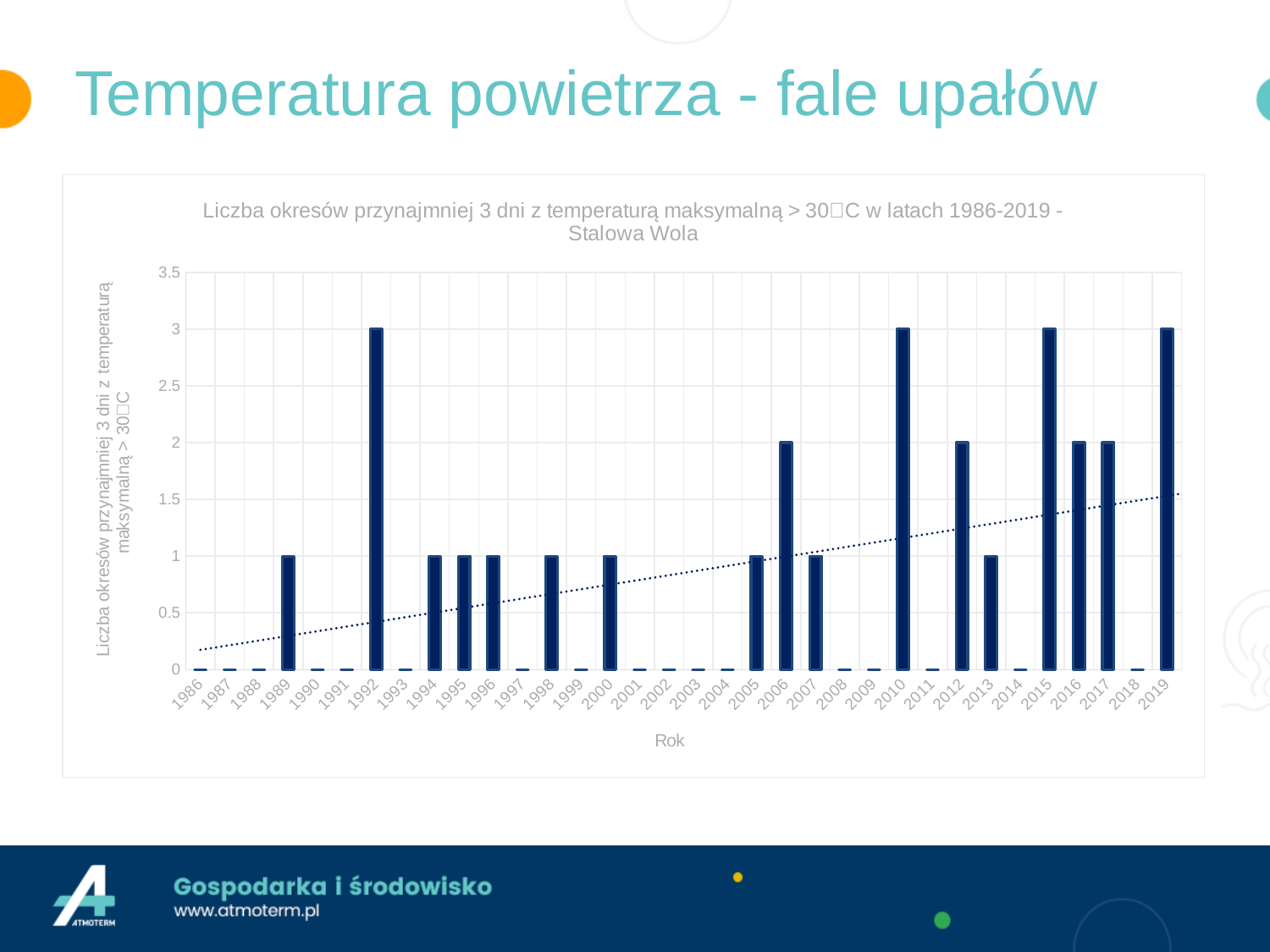
How many years are shown on the x axis of the chart? 34 What is the highest value reached by any bar in the chart? 3 Which years reach the highest value of 3? 1992, 2010, 2015, 2019 Does the dotted trend line rise or fall from 1986 to 2019? rises How many periods of at least 3 days with maximum temperature above 30°C were recorded in 1992? 3 What is the value shown for the year 2006? 2 What is the difference between the values for 2006 and 2005? 1 What is the value shown for the year 2018? 0 What kind of chart is shown on the slide? bar chart What is the value shown for the year 2013? 1 Which year has the larger value, 2012 or 2013? 2012 What is the label of the x axis? Rok